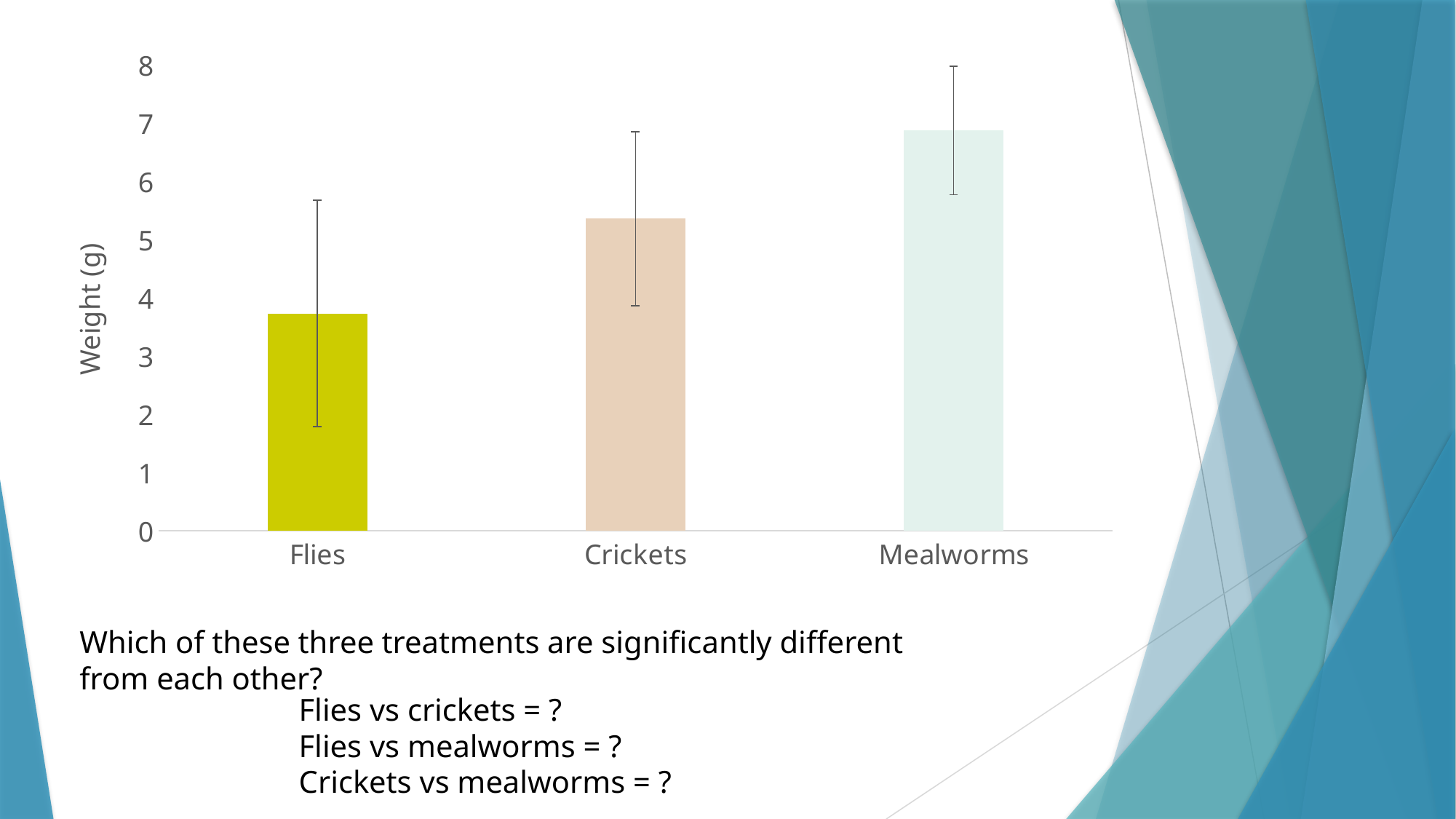
What is the label on the y axis of the chart? Weight (g) Do the bar values rise or fall from left to right across the x axis? rise Is the value for Flies greater or less than 3? greater Which has a larger weight value, Crickets or Mealworms? Mealworms Which category has the lowest weight in the chart? Flies Which has a larger weight value, Flies or Crickets? Crickets Is the value for Flies greater or less than 4? less What kind of chart is shown on the slide? bar chart Is the value for Mealworms greater or less than 6? greater How many categories are plotted on the x axis of the chart? 3 Which category has the highest weight in the chart? Mealworms